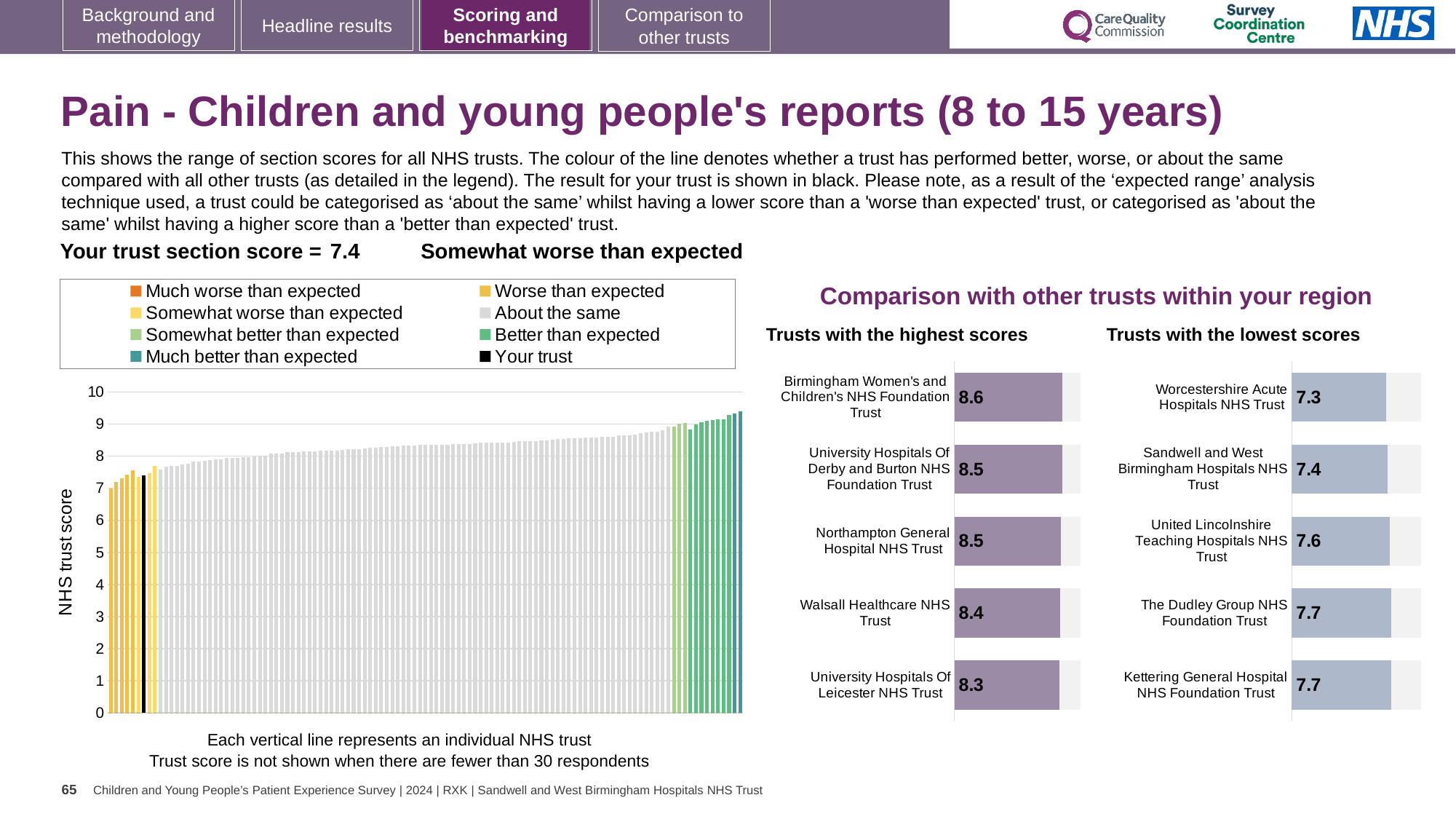
In the main 'NHS trust score' chart, do the bar values rise or fall from left to right? Rise What kind of chart is the main 'NHS trust score' chart on the left of the slide? Bar chart In the 'Trusts with the lowest scores' chart, what is the score for Worcestershire Acute Hospitals NHS Trust? 7.3 In the 'Trusts with the lowest scores' chart, what is the score for United Lincolnshire Teaching Hospitals NHS Trust? 7.6 What is the difference between the score for Birmingham Women's and Children's NHS Foundation Trust in the highest scores chart and the score for Worcestershire Acute Hospitals NHS Trust in the lowest scores chart? 1.3 In the 'Trusts with the lowest scores' chart, which has the larger score: Sandwell and West Birmingham Hospitals NHS Trust or The Dudley Group NHS Foundation Trust? The Dudley Group NHS Foundation Trust In the 'Trusts with the highest scores' chart, which trust has the lowest score? University Hospitals Of Leicester NHS Trust In the 'Trusts with the highest scores' chart, what is the score for Birmingham Women's and Children's NHS Foundation Trust? 8.6 How many trusts are shown in the 'Trusts with the highest scores' chart? 5 In the 'Trusts with the lowest scores' chart, which trust has the lowest score? Worcestershire Acute Hospitals NHS Trust How many entries does the legend of the main 'NHS trust score' chart list? 8 In the 'Trusts with the highest scores' chart, what is the score for Walsall Healthcare NHS Trust? 8.4